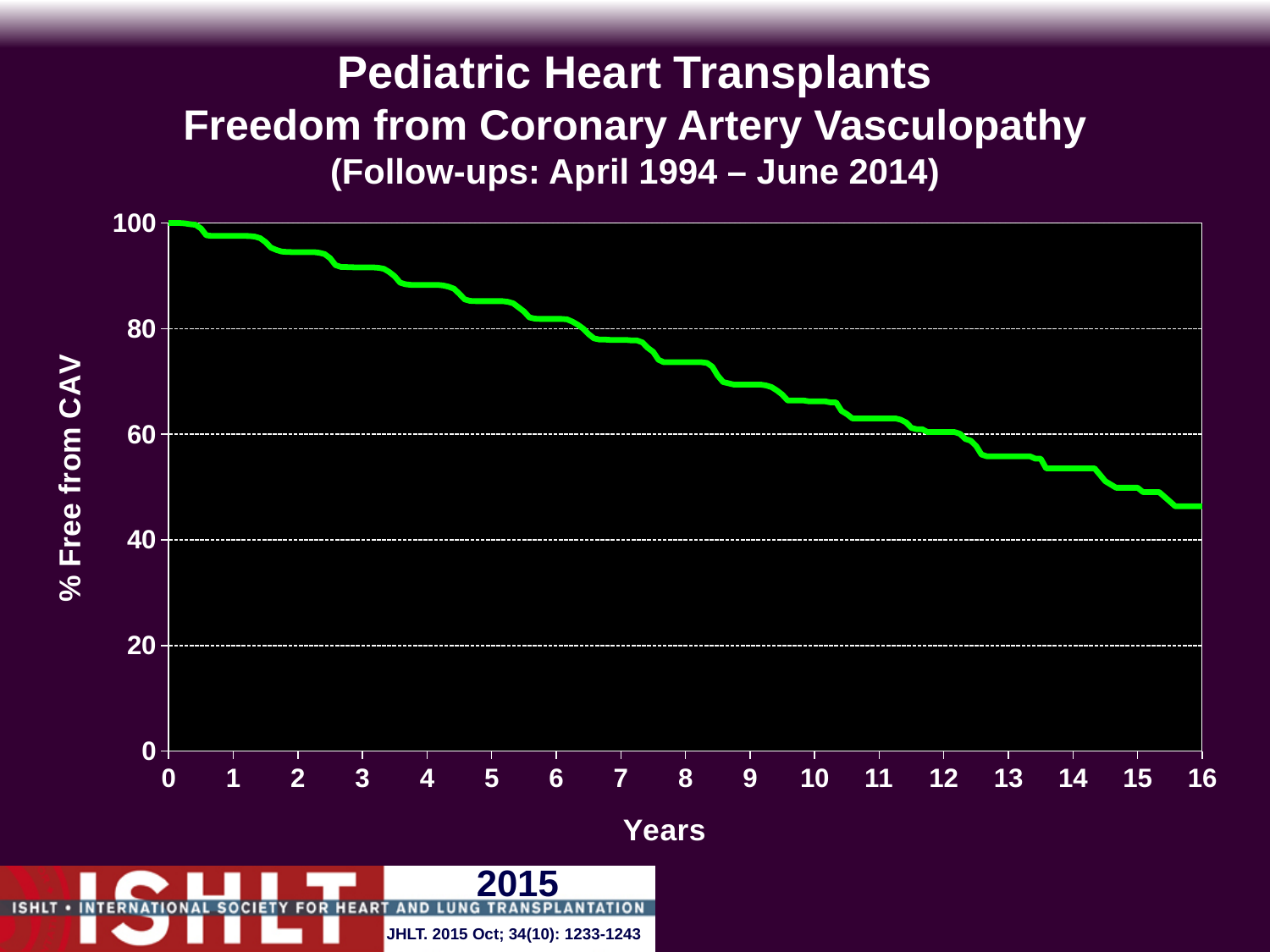
Is the % free from CAV at year 8 greater or less than 60? greater What kind of chart is shown on the slide? line chart Is the % free from CAV at year 14 greater or less than 60? less Do the values rise or fall as the years increase along the x axis? fall At which year is the % free from CAV highest? 0 What is the label of the y axis? % Free from CAV Is the % free from CAV higher at year 2 or at year 10? year 2 Is the % free from CAV at year 8 greater or less than 80? less At which year shown on the x axis is the % free from CAV lowest? 16 What is the % free from CAV at year 0? 100